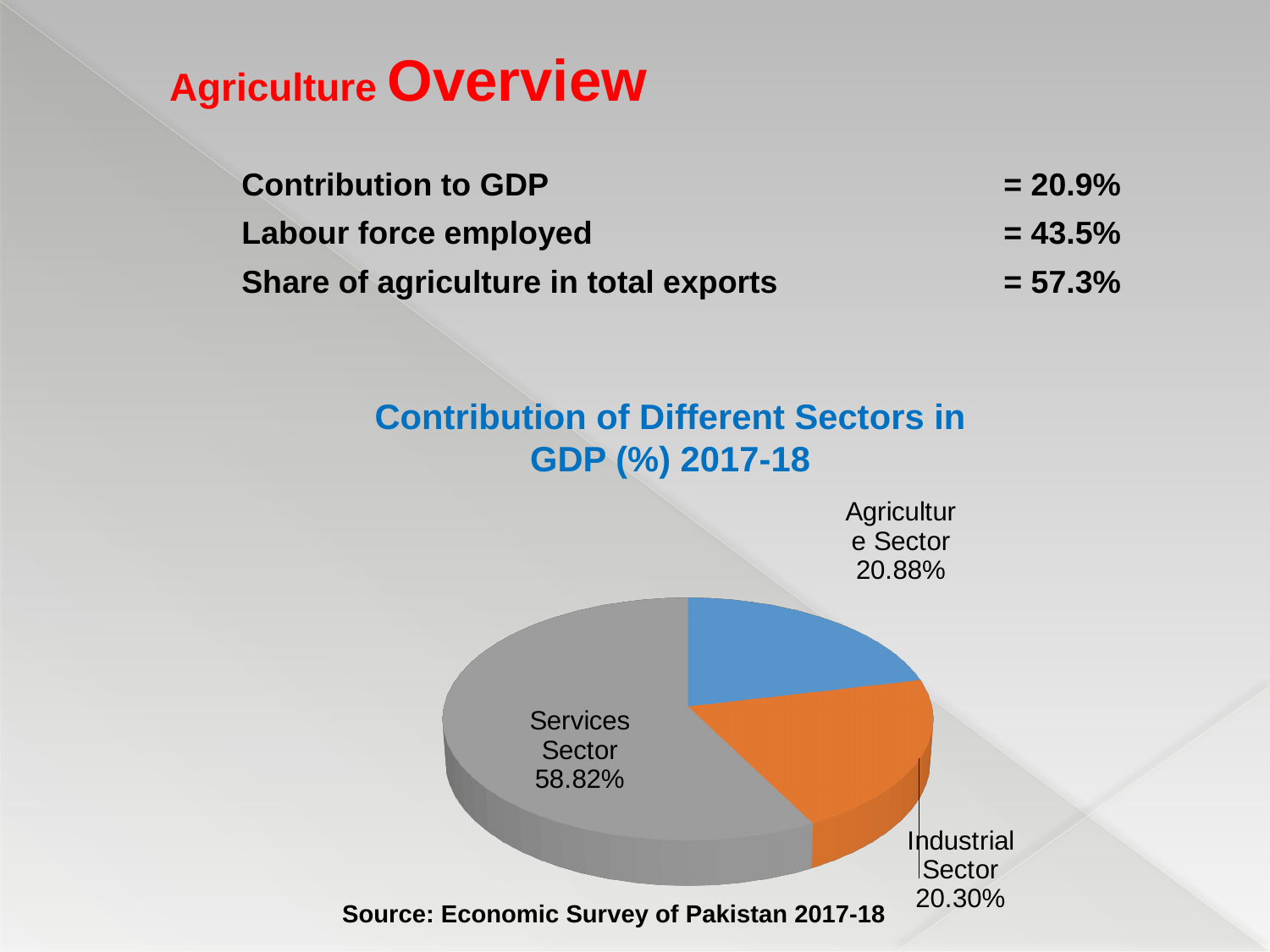
What is the value shown for the Services Sector? 58.82% What kind of chart is shown on the slide? pie chart What is the title of the chart? Contribution of Different Sectors in GDP (%) 2017-18 Which sector has the smallest share of the pie? Industrial Sector Which sector has the largest share of the pie? Services Sector What is the difference between the Agriculture Sector and the Industrial Sector values? 0.58% What is the difference between the Services Sector and the Agriculture Sector values? 37.94% Which is larger, the Services Sector share or the Industrial Sector share? Services Sector What is the value shown for the Agriculture Sector? 20.88% How many sectors (slices) are shown in the pie chart? 3 What colour is the Services Sector slice? grey What is the value shown for the Industrial Sector? 20.30%